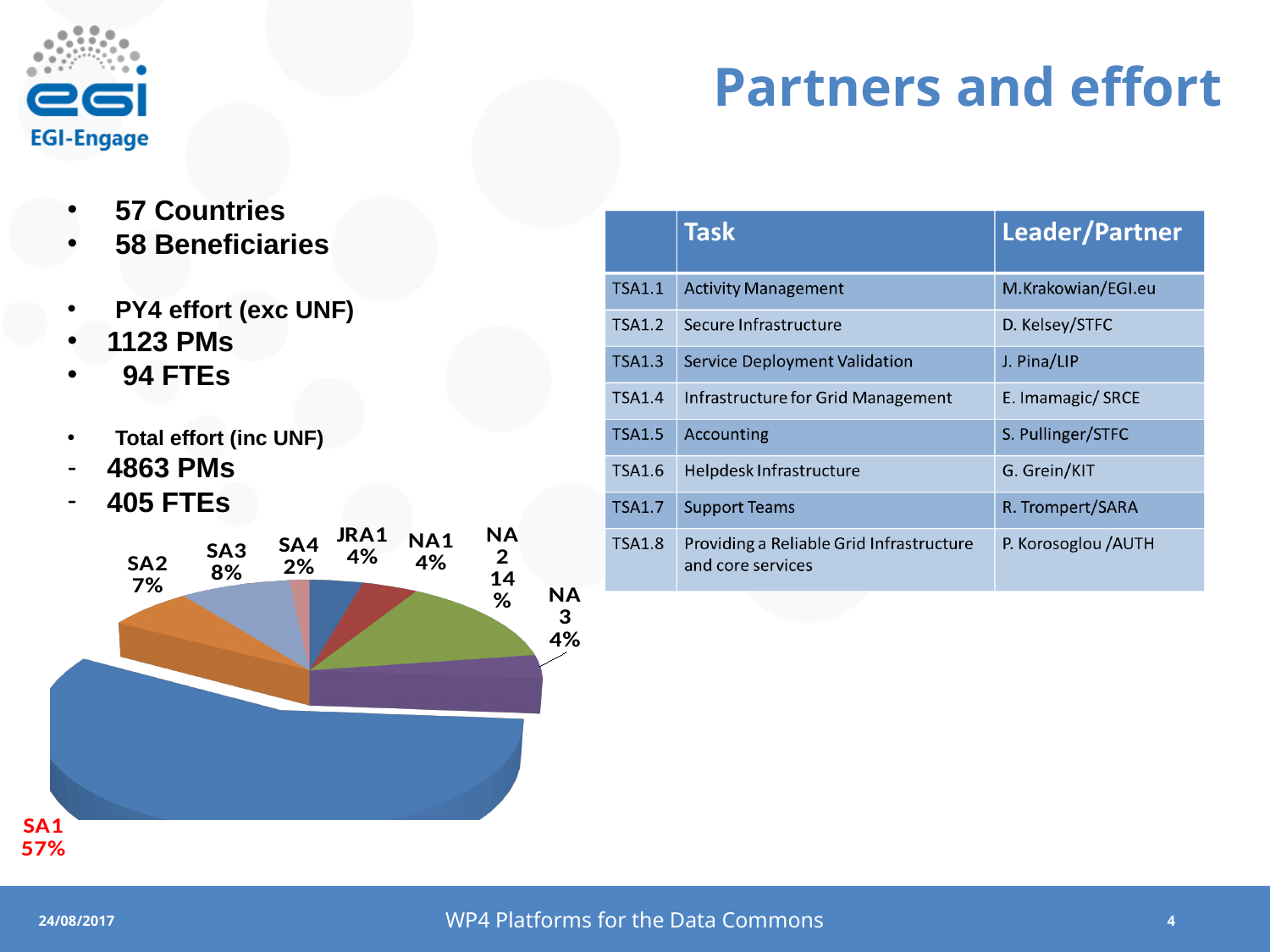
What is the value shown for SA3 in the pie chart? 8% What is the value shown for SA2 in the pie chart? 7% How many slices does the pie chart have? 8 What is the difference between the SA1 share and the NA2 share? 43% What kind of chart is shown on the slide? pie chart What colour is the SA1 slice in the pie chart? blue What is the difference between the SA3 share and the SA4 share? 6% Which slice of the pie chart is the smallest? SA4 Which is larger in the pie chart, SA3 or SA2? SA3 What share of the pie does SA1 have? 57% Which slice of the pie chart is the largest? SA1 What share of the pie does NA2 have? 14%